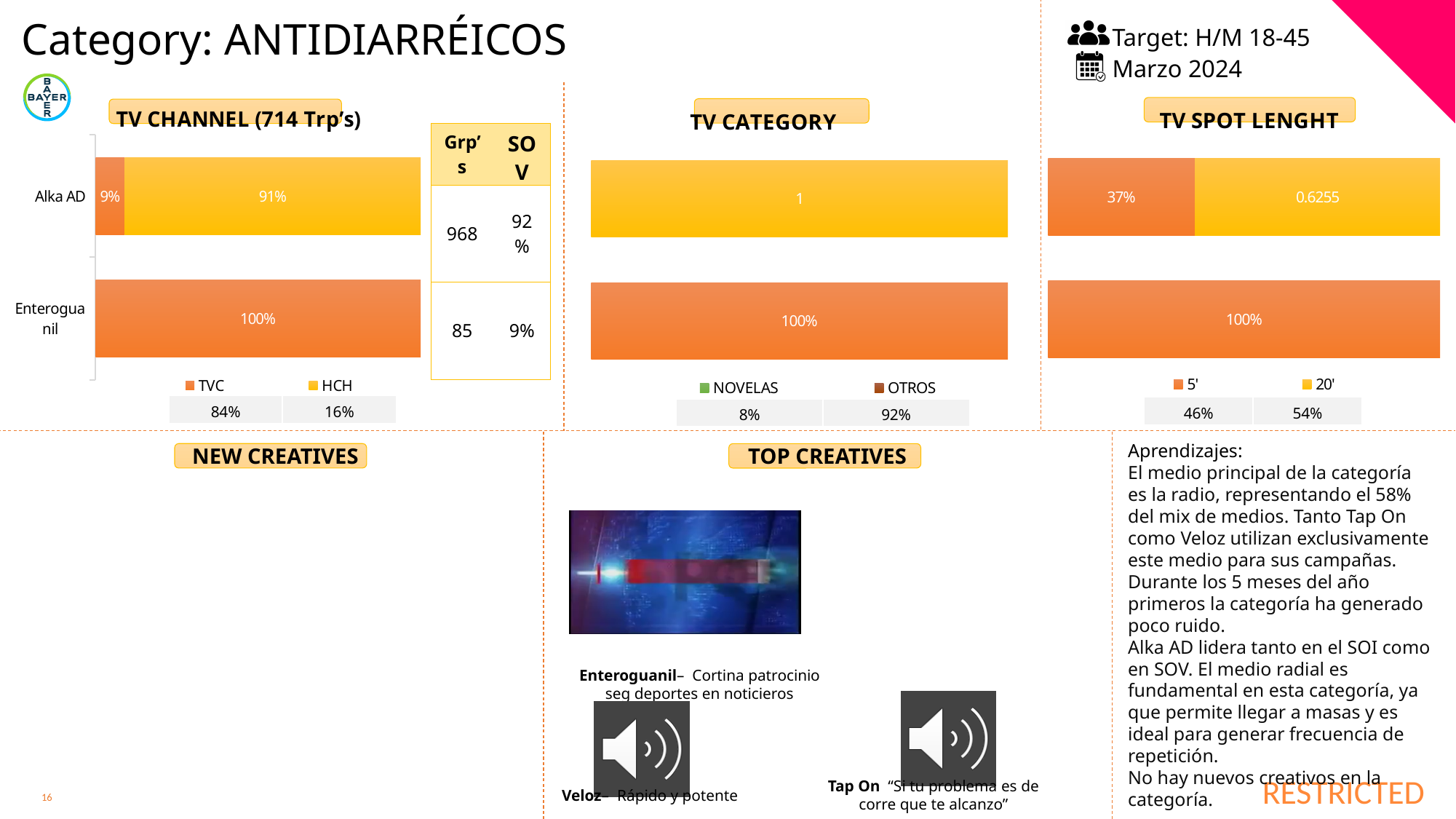
In the TV CHANNEL chart, what value is labelled on the Enteroguanil bar? 100% What are the two legend entries of the TV CATEGORY chart? NOVELAS and OTROS How many brands are plotted in the TV CHANNEL chart? 2 How many series does the legend of the TV CHANNEL chart list? 2 In the TV SPOT LENGHT chart, what value is labelled on the yellow (20') segment of the top bar? 0.6255 In the TV CHANNEL chart, what percentage is shown for the HCH segment of Alka AD? 91% In the TV SPOT LENGHT chart, what percentage is labelled on the orange (5') segment of the top bar? 37% In the TV CHANNEL chart, what percentage is shown for the TVC segment of Alka AD? 9% In the TV CHANNEL chart, what is the difference between the HCH and TVC percentages for Alka AD? 82 percentage points In the TV CHANNEL chart, what is the total of the Alka AD stacked bar? 100% What type of chart is the TV CHANNEL chart? Bar chart In the TV CHANNEL chart, which brand has the larger TVC share, Alka AD or Enteroguanil? Enteroguanil